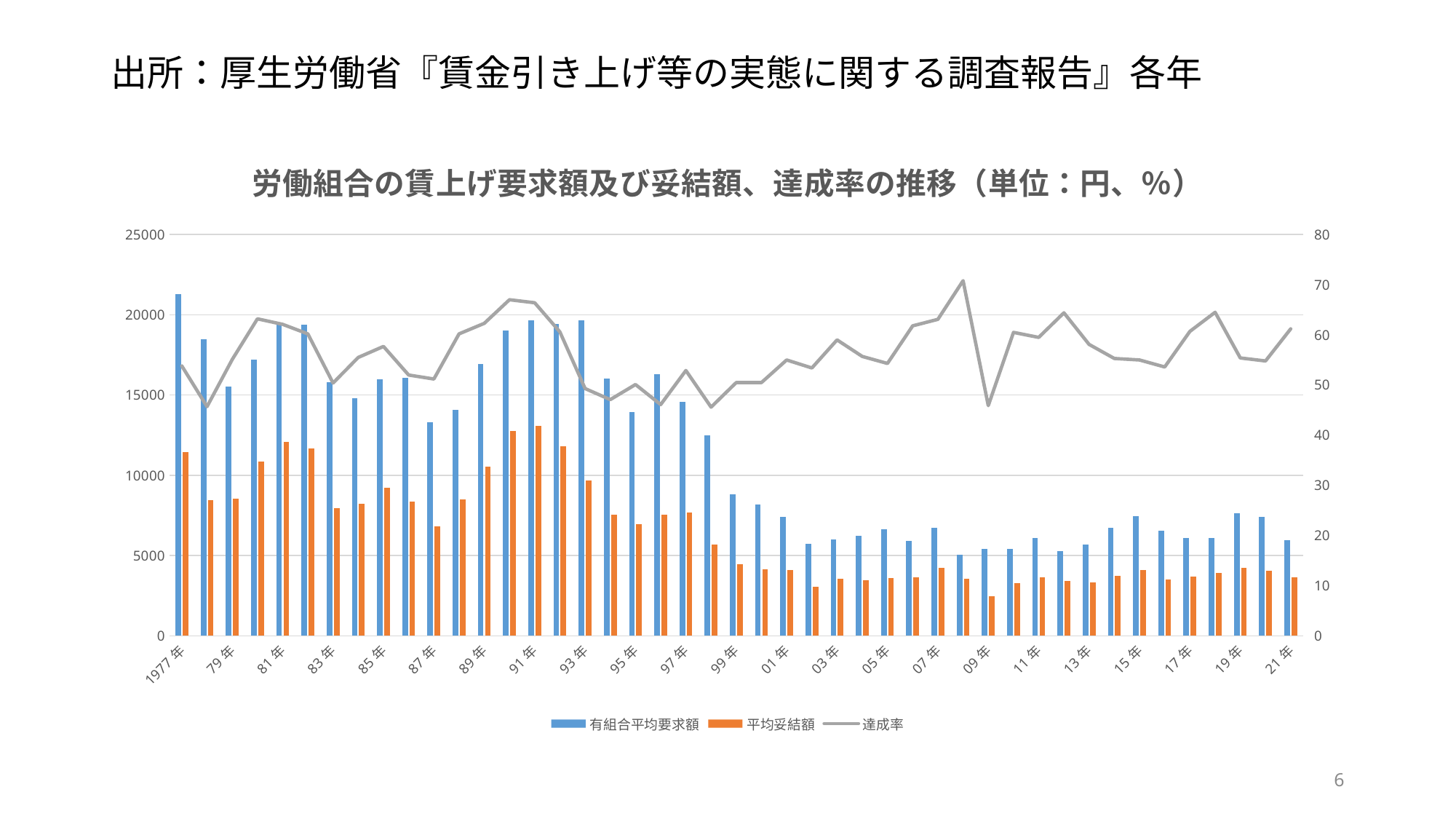
What kind of chart is shown on the slide? A combination bar and line chart Is the 有組合平均要求額 value for 1977年 greater or less than 20000? greater In which year is the 有組合平均要求額 bar the highest? 1977年 Which is larger, the 平均妥結額 for 91年 or for 21年? 91年 Is the 平均妥結額 value for 09年 greater or less than 5000? less What is the title of the chart? 労働組合の賃上げ要求額及び妥結額、達成率の推移（単位：円、%） Is the 有組合平均要求額 value for 21年 greater or less than 10000? less In which labeled year is the 平均妥結額 bar the lowest? 09年 Which series is drawn as a grey line? 達成率 How many series does the legend list? 3 Overall, do the 有組合平均要求額 bars rise or fall from 1977年 to 21年? fall